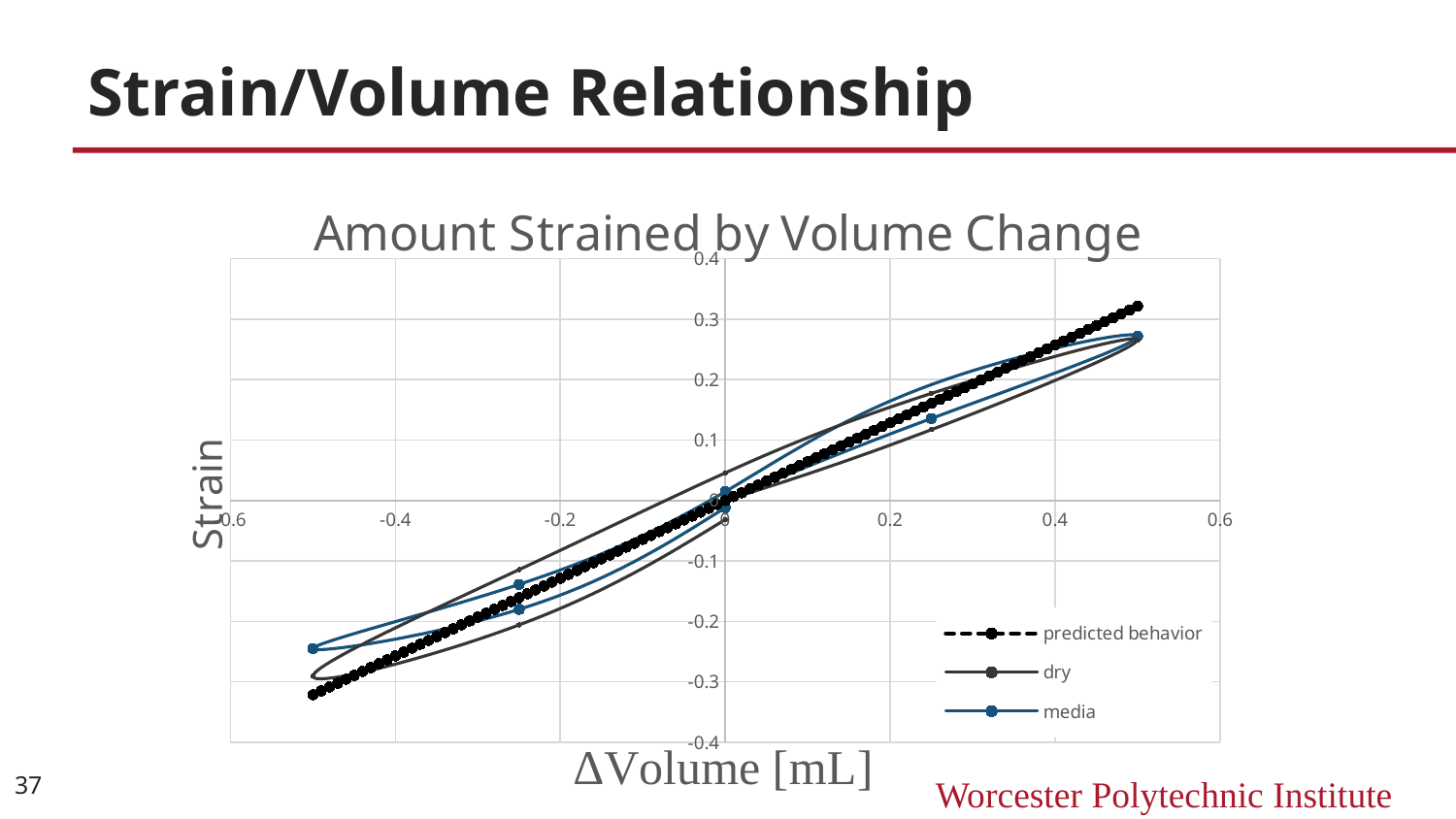
What is the title of the chart? Amount Strained by Volume Change Do the strain values rise or fall as ΔVolume increases along the x axis? rise Is the strain value for the predicted behavior series at ΔVolume -0.5 mL greater or less than -0.3? less Is the strain value for the media series at ΔVolume -0.5 mL greater or less than -0.3? greater What are the names of the three series in the legend? predicted behavior, dry, media At ΔVolume 0.5 mL, which series has the higher strain value, predicted behavior or media? predicted behavior What kind of chart is shown on the slide? line chart How many series does the legend list? 3 What is the highest value shown on the y axis (Strain)? 0.4 Is the strain value for the media series at ΔVolume 0.25 mL greater or less than 0.1? greater